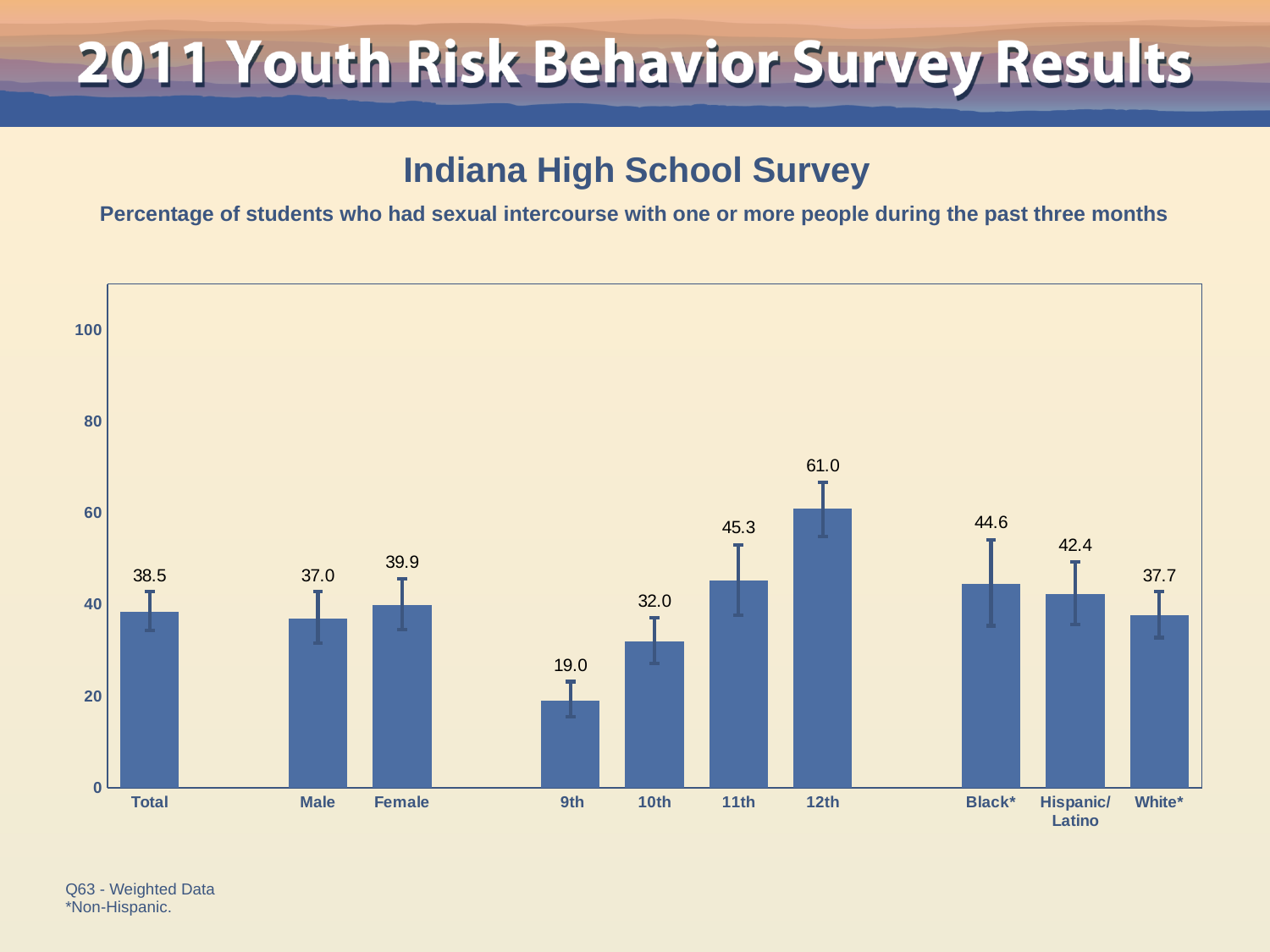
What is the value for Total? 38.5 Which category has the highest value? 12th Which category has the lowest value? 9th How many categories are shown on the x axis? 10 Do the values rise or fall from 9th grade to 12th grade? rise What is the value for Hispanic/Latino students? 42.4 Is the value for 11th graders greater or less than 40? greater What is the difference between the Female and Male values? 2.9 What kind of chart is this? bar chart Which is larger, the value for Black* or the value for White*? Black* What is the difference between the 12th and 9th grade values? 42.0 What is the value for 12th graders? 61.0